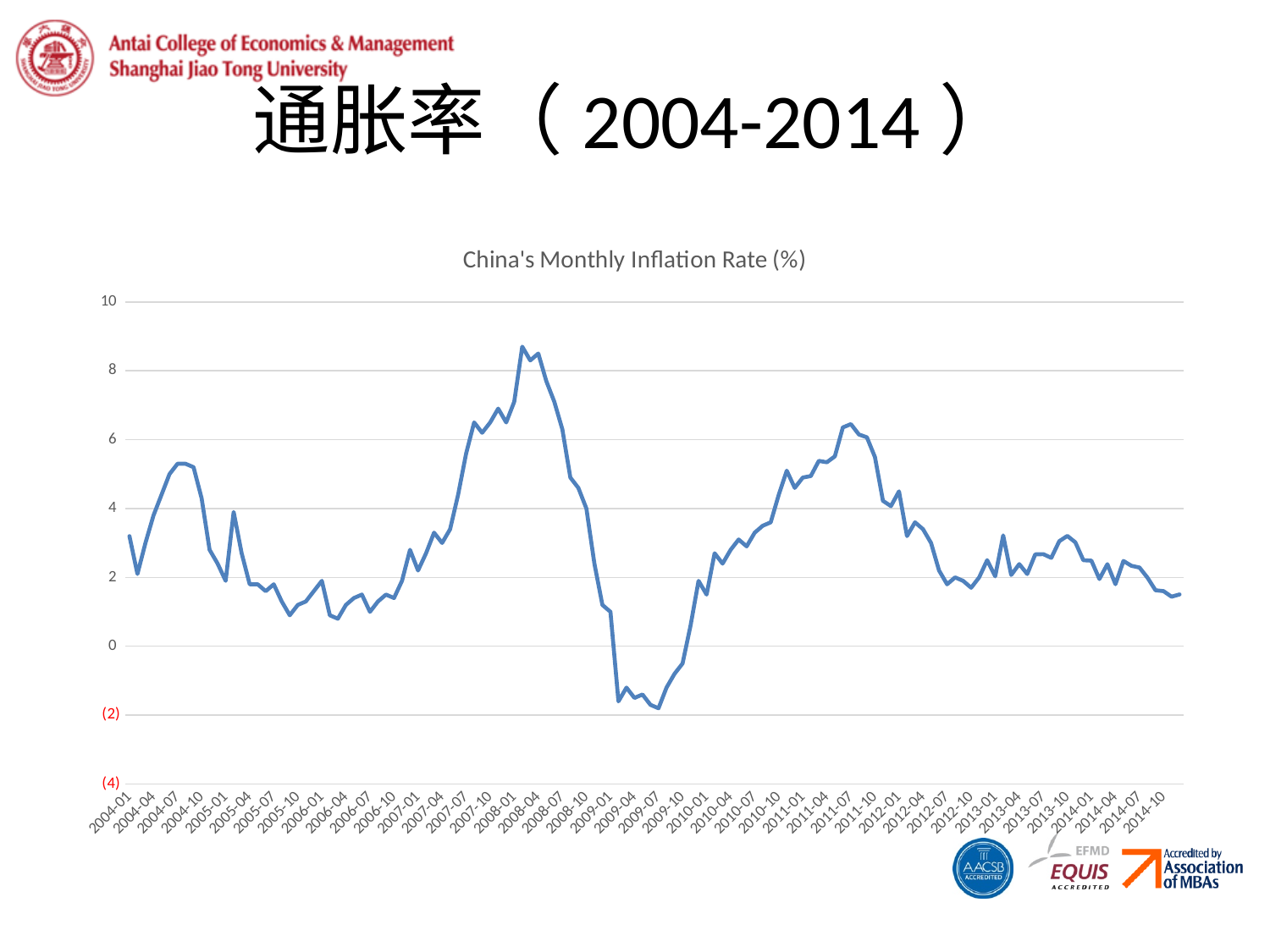
Is the value for 2011-07 greater or less than 4? greater Is the value for 2004-01 greater or less than 2? greater Which is larger, the value for 2008-04 or the value for 2014-10? 2008-04 In which year does the line reach its highest point? 2008 What kind of chart is shown on the slide? line chart Is the value for 2009-07 greater or less than 0? less What is the title of the chart? China's Monthly Inflation Rate (%) Does the inflation rate rise or fall between 2009-07 and 2011-07? rise Does the inflation rate rise or fall between 2008-04 and 2009-07? fall In which year does the line reach its lowest point? 2009